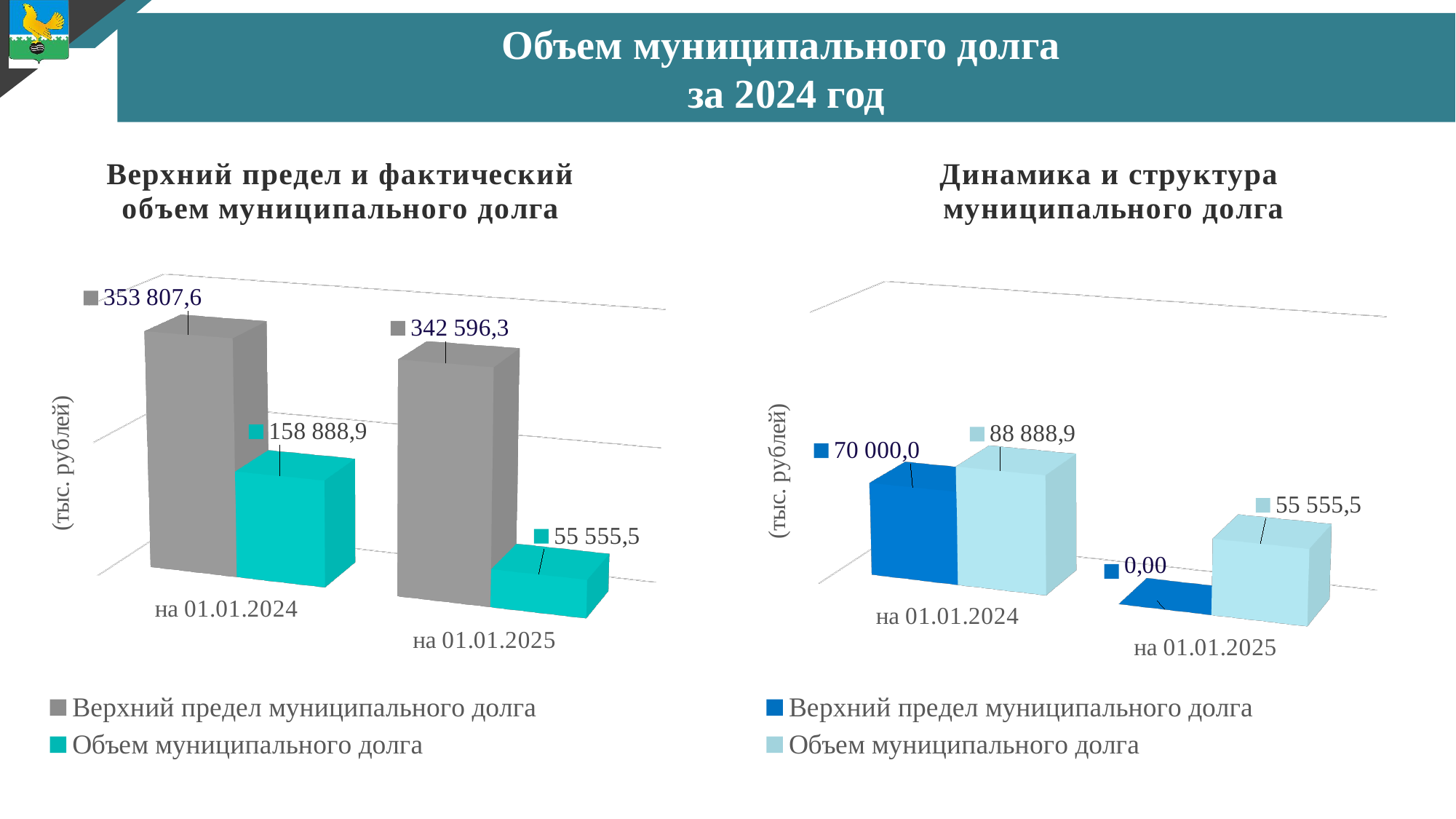
What kind of chart is 'Динамика и структура муниципального долга'? bar chart In the chart 'Верхний предел и фактический объем муниципального долга', what is the difference between 'Верхний предел муниципального долга' on 01.01.2024 and on 01.01.2025? 11 211,3 In the chart 'Динамика и структура муниципального долга', which date has the lowest value of 'Верхний предел муниципального долга'? на 01.01.2025 In the chart 'Верхний предел и фактический объем муниципального долга', by how much did 'Объем муниципального долга' fall from 01.01.2024 to 01.01.2025? 103 333,4 In the chart 'Верхний предел и фактический объем муниципального долга', does 'Объем муниципального долга' rise or fall from 01.01.2024 to 01.01.2025? fall How many series does the legend of the chart 'Верхний предел и фактический объем муниципального долга' list? 2 In the chart 'Динамика и структура муниципального долга', what is the difference between 'Объем муниципального долга' on 01.01.2024 and on 01.01.2025? 33 333,4 In the chart 'Динамика и структура муниципального долга', which is larger on 01.01.2024: 'Верхний предел муниципального долга' or 'Объем муниципального долга'? Объем муниципального долга In the chart 'Динамика и структура муниципального долга', what is the value of 'Верхний предел муниципального долга' on 01.01.2025? 0,00 In the chart 'Динамика и структура муниципального долга', what is the value of 'Объем муниципального долга' on 01.01.2024? 88 888,9 In the chart 'Верхний предел и фактический объем муниципального долга', what is the value of 'Объем муниципального долга' on 01.01.2025? 55 555,5 In the chart 'Верхний предел и фактический объем муниципального долга', what is the value of 'Верхний предел муниципального долга' on 01.01.2024? 353 807,6